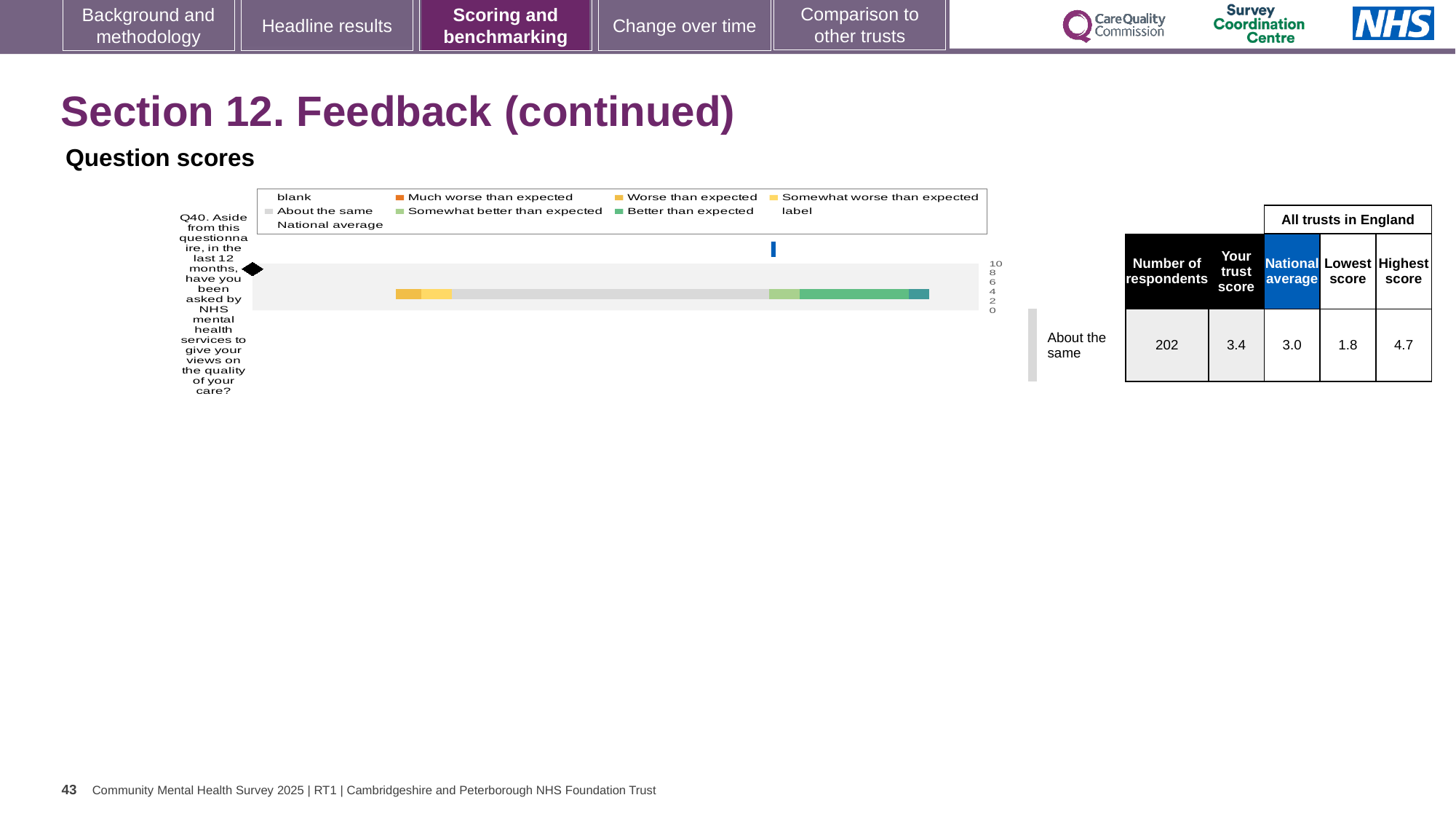
Which question number is plotted in the chart? Q40 How many questions are plotted in the chart? 1 In the table next to the chart, what is the national average for Q40? 3.0 In the table next to the chart, what is the number of respondents for Q40? 202 In the table next to the chart, what is the lowest score among all trusts in England for Q40? 1.8 In the table next to the chart, what is your trust score for Q40? 3.4 Which is larger for Q40, your trust score or the national average? Your trust score What rating label is shown to the right of the chart for Q40? About the same In the table next to the chart, what is the highest score among all trusts in England for Q40? 4.7 What is the difference between the highest score and the lowest score for Q40? 2.9 What kind of chart is shown on the slide? bar chart What is the difference between your trust score and the national average for Q40? 0.4